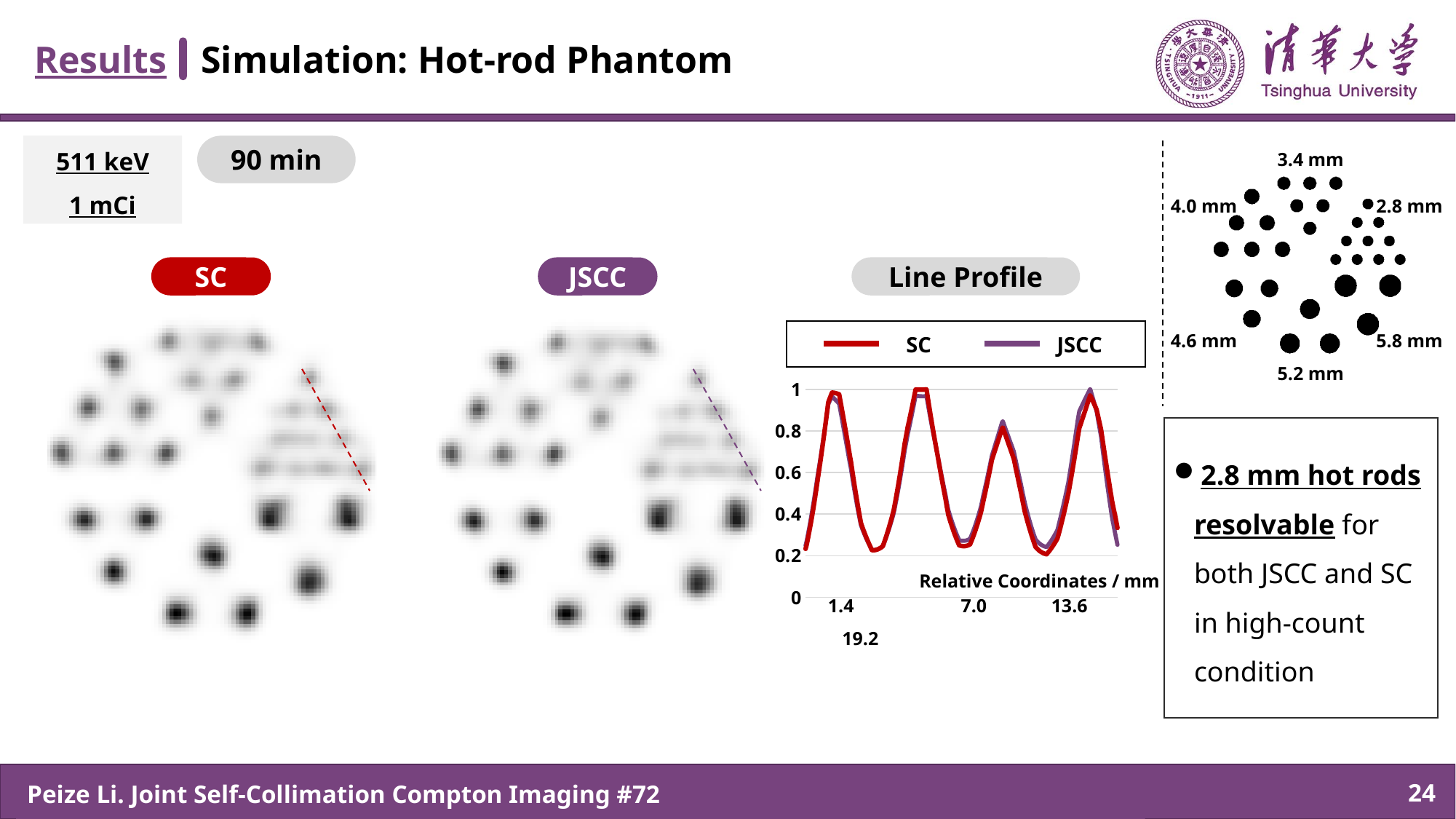
What is the x-axis title of the Line Profile chart? Relative Coordinates / mm In the Line Profile chart, is the trough between the first and second peaks of the SC line greater or less than 0.4? less How many peaks do the lines in the Line Profile chart show? 4 In the Line Profile chart, is the second peak of the SC line greater or less than 0.6? greater What colour is the SC line in the Line Profile chart? red What are the two series named in the legend of the Line Profile chart? SC and JSCC What is the largest x-axis tick label shown on the Line Profile chart? 19.2 What is the highest tick value shown on the y-axis of the Line Profile chart? 1 In the Line Profile chart, is the third peak of the JSCC line greater or less than 1? less What kind of chart is the Line Profile chart? line chart How many series does the legend of the Line Profile chart list? 2